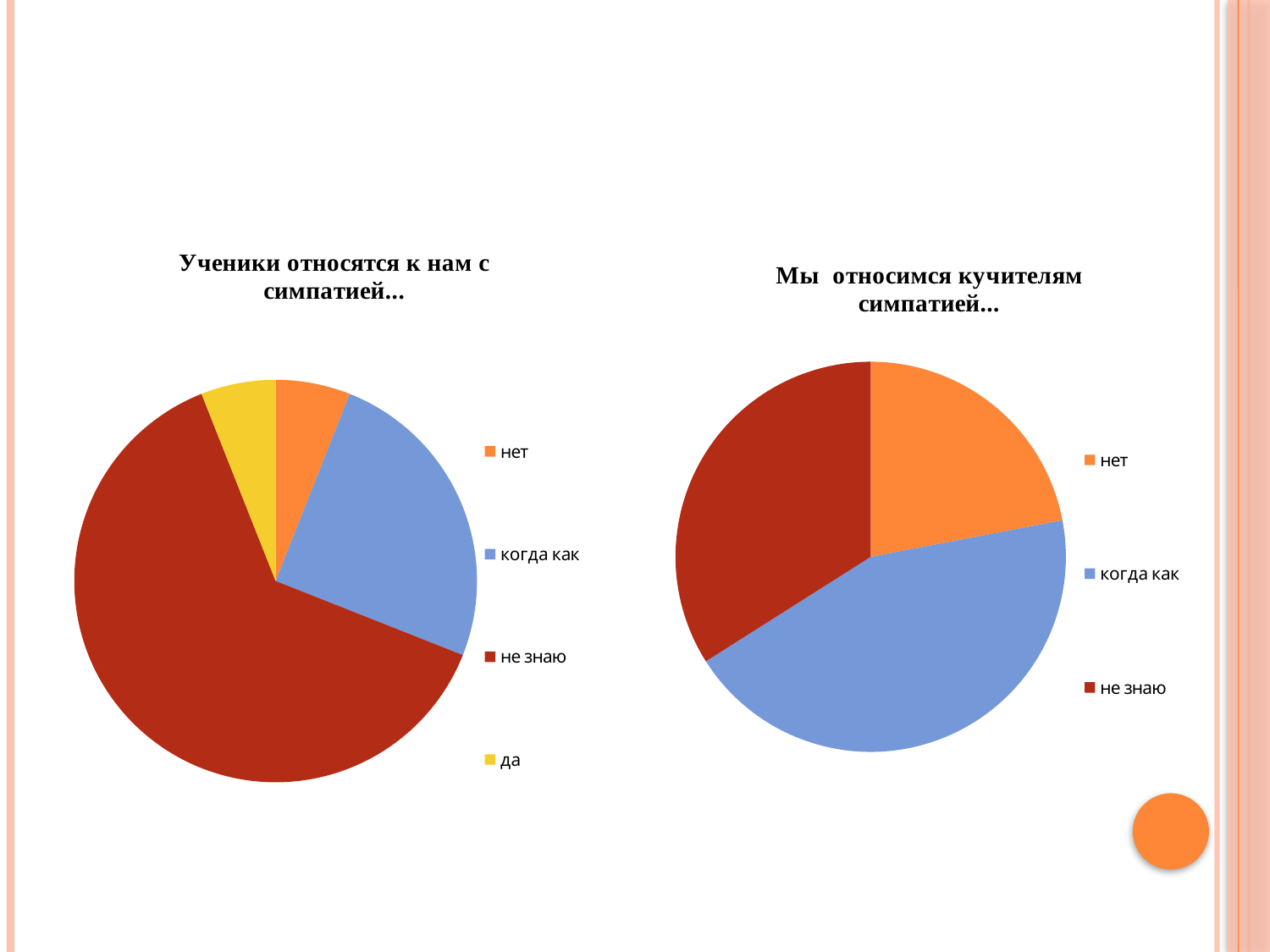
In the left chart "Ученики относятся к нам с симпатией...", what colour is the "да" slice? yellow In the right chart "Мы относимся кучителям симпатией...", which slice is larger: "не знаю" or "нет"? не знаю What kind of chart is the right chart titled "Мы относимся кучителям симпатией..."? pie chart In the right chart "Мы относимся кучителям симпатией...", which category has the smallest slice? нет What kind of chart is the left chart titled "Ученики относятся к нам с симпатией..."? pie chart In the left chart "Ученики относятся к нам с симпатией...", which slice is larger: "когда как" or "нет"? когда как In the right chart "Мы относимся кучителям симпатией...", how many categories does the legend list? 3 In the left chart "Ученики относятся к нам с симпатией...", which category has the largest slice? не знаю In the left chart "Ученики относятся к нам с симпатией...", how many categories does the legend list? 4 Which legend category appears in the left chart but not in the right chart? да In the right chart "Мы относимся кучителям симпатией...", which category has the largest slice? когда как In the left chart "Ученики относятся к нам с симпатией...", which slice is larger: "не знаю" or "когда как"? не знаю